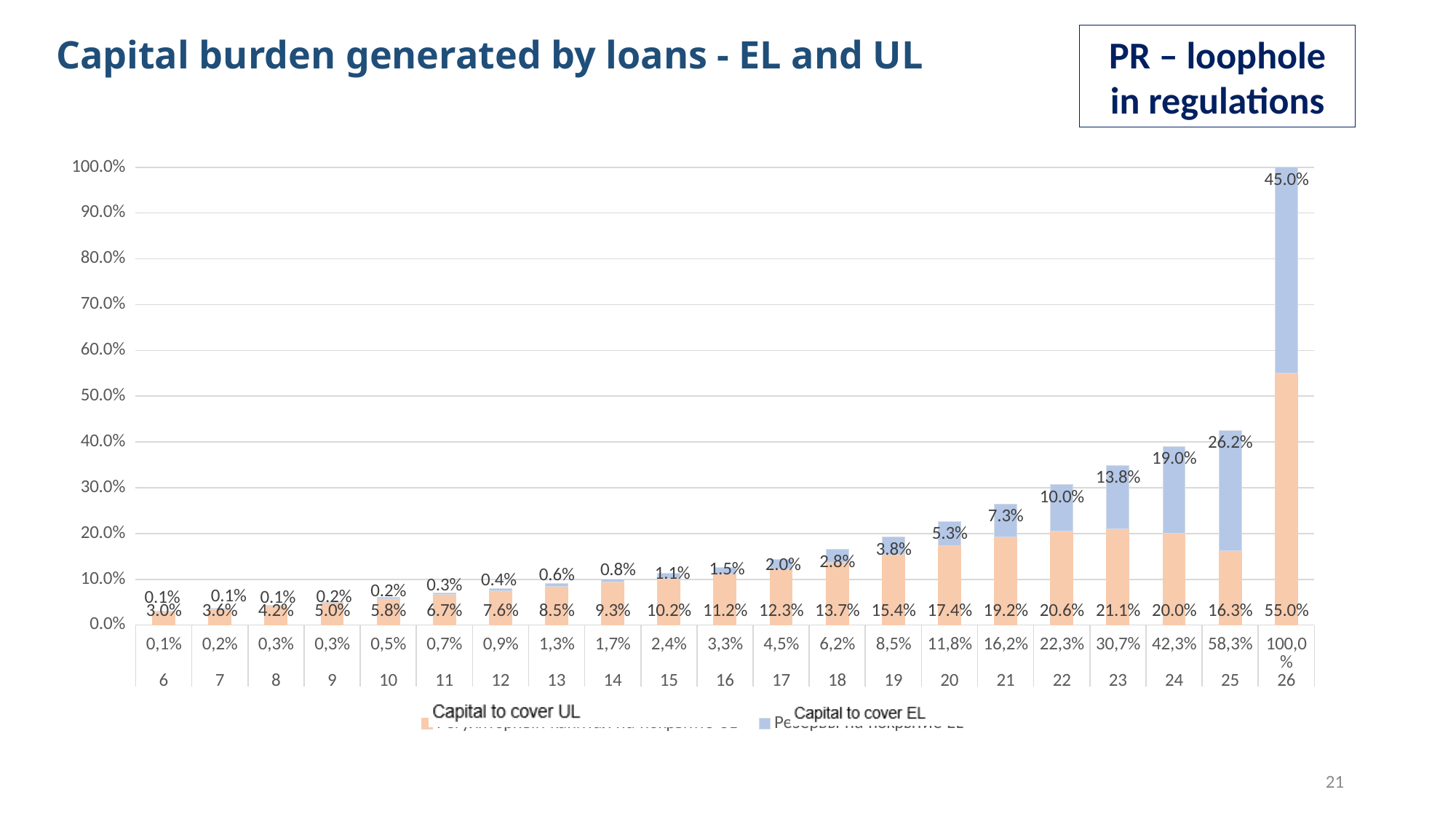
How many categories are shown on the x axis? 21 What is the difference between the Capital to cover UL values for category 23 and category 6? 18.1% What is the total height of the stacked bar for category 26? 100.0% Which category has the lowest Capital to cover UL value? 6 Which category has the highest Capital to cover EL value? 26 What is the value of Capital to cover UL for category 26? 55.0% What is the total height of the stacked bar for category 24? 39.0% What is the value of Capital to cover EL for category 22? 10.0% Which has the larger Capital to cover UL value, category 24 or category 25? Category 24 Do the Capital to cover EL values rise or fall from category 6 to category 26? Rise How many series does the legend list? 2 What kind of chart is shown on the slide? Stacked bar chart